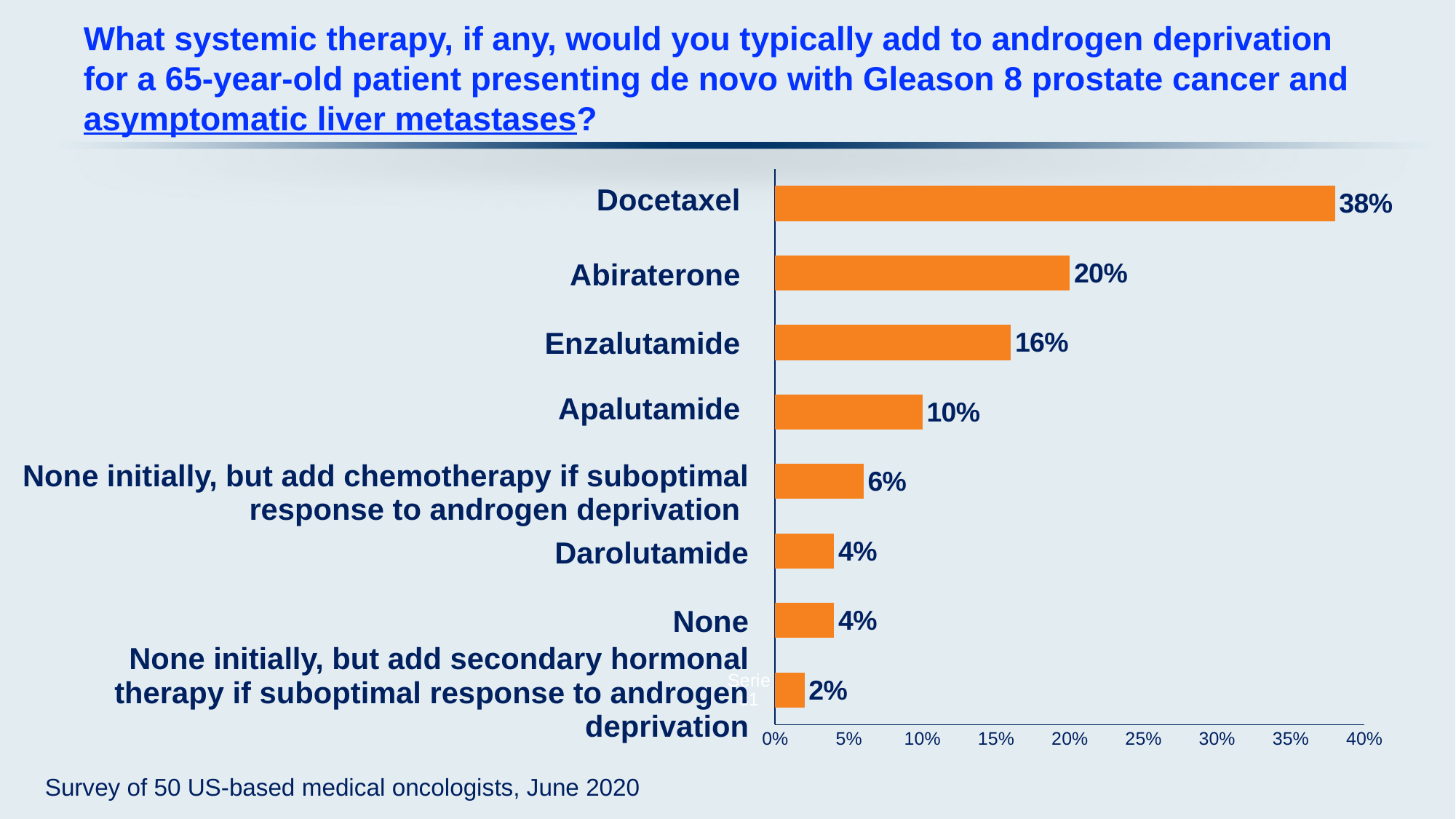
What is the maximum value shown on the percentage axis? 40% What is the value for 'None initially, but add chemotherapy if suboptimal response to androgen deprivation'? 6% What percentage of respondents chose Docetaxel? 38% What percentage is shown for Enzalutamide? 16% What is the difference between Enzalutamide and Apalutamide? 6% What type of chart is shown on the slide? Bar chart What is the value shown for Abiraterone? 20% How many categories (bars) are shown in the chart? 8 Which option has the lowest percentage? None initially, but add secondary hormonal therapy if suboptimal response to androgen deprivation What is the difference in percentage points between Docetaxel and Abiraterone? 18% Which therapy option has the highest percentage? Docetaxel Which has a larger value, Apalutamide or Darolutamide? Apalutamide